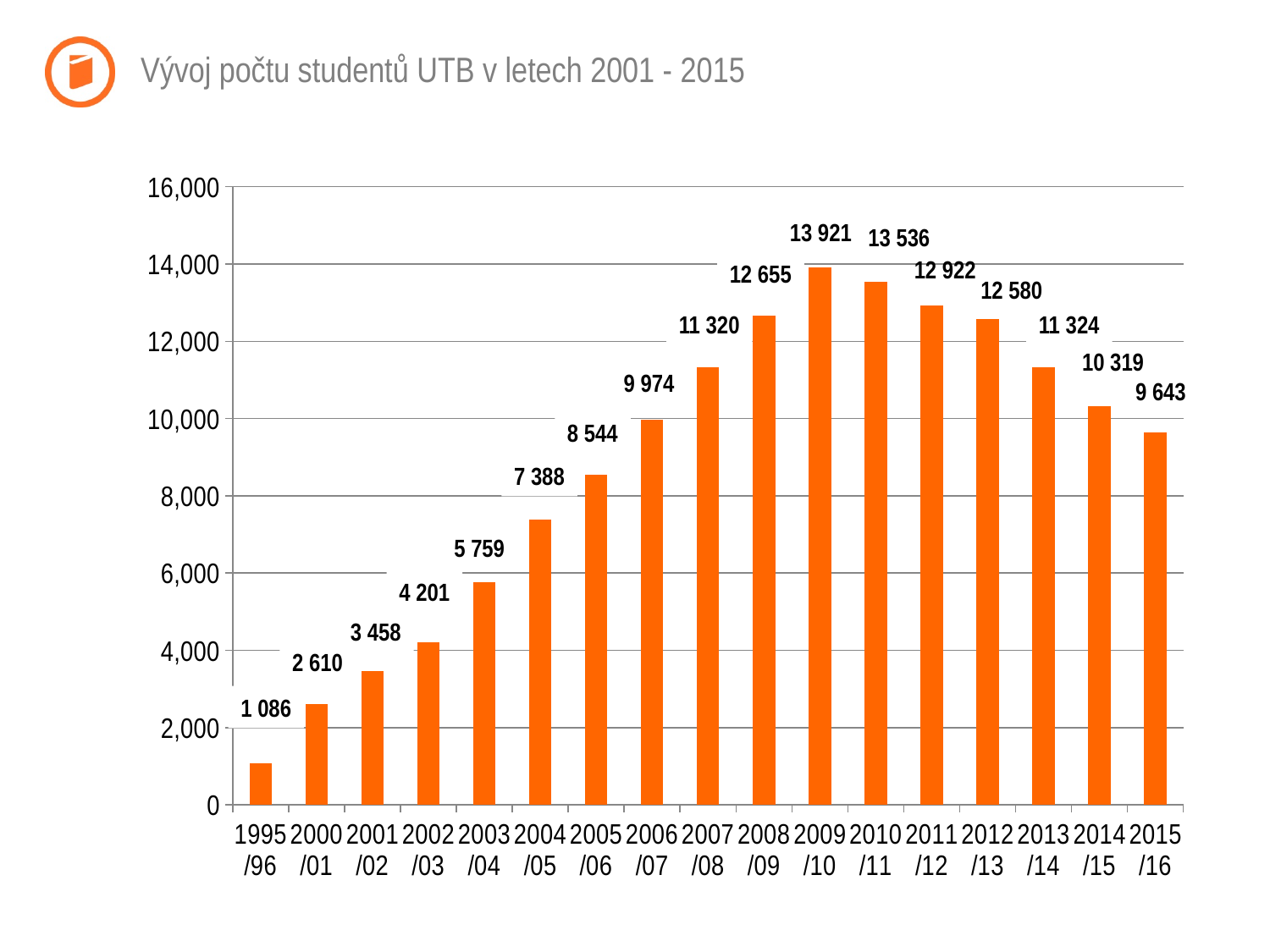
Which academic year has the lowest number of students? 1995/96 What is the value shown for 2003/04? 5 759 What is the title of the chart? Vývoj počtu studentů UTB v letech 2001 - 2015 What is the value shown for 2015/16? 9 643 What is the difference between the values for 2009/10 and 2015/16? 4 278 Do the values rise or fall from 2009/10 to 2015/16? Fall How many academic years are shown on the x axis? 17 How many students does the chart show for 2009/10? 13 921 Which is larger, the value for 2010/11 or the value for 2011/12? 2010/11 Which academic year has the highest number of students? 2009/10 What is the difference between the values for 2008/09 and 2007/08? 1 335 What kind of chart is shown on the slide? Bar chart